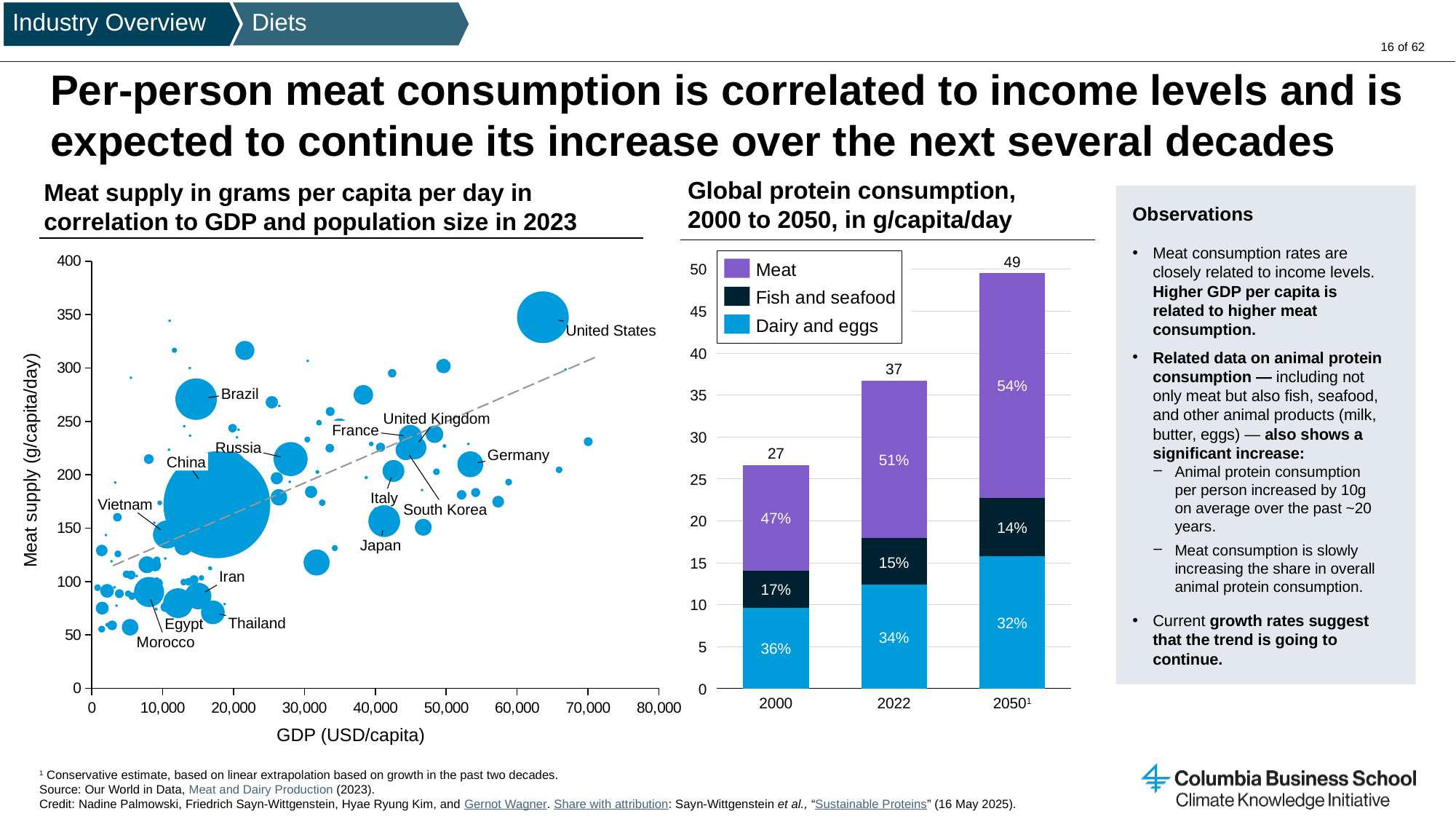
What kind of chart is the 'Global protein consumption, 2000 to 2050' chart? Stacked bar chart In the 'Global protein consumption, 2000 to 2050' chart, do the total values rise or fall from 2000 to 2050? Rise In the 'Meat supply in grams per capita per day' chart on the left, is the meat supply value for the United States greater or less than 300? greater In the 'Meat supply in grams per capita per day' chart on the left, which has the higher meat supply, Brazil or Japan? Brazil In the 'Global protein consumption, 2000 to 2050' chart, what share of the 2000 bar is Fish and seafood? 17% How many series does the legend of the 'Global protein consumption, 2000 to 2050' chart list? 3 In the 'Global protein consumption, 2000 to 2050' chart, what share of the 2050 bar is Dairy and eggs? 32% In the 'Global protein consumption, 2000 to 2050' chart, what is the total value shown for 2000? 27 In the 'Meat supply in grams per capita per day' chart on the left, is the meat supply value for Japan greater or less than 200? less In the 'Global protein consumption, 2000 to 2050' chart, what is the total value shown for 2050? 49 In the 'Global protein consumption, 2000 to 2050' chart, what share of the 2022 bar is Meat? 51% In the 'Global protein consumption, 2000 to 2050' chart, what is the difference between the 2050 total and the 2000 total? 22